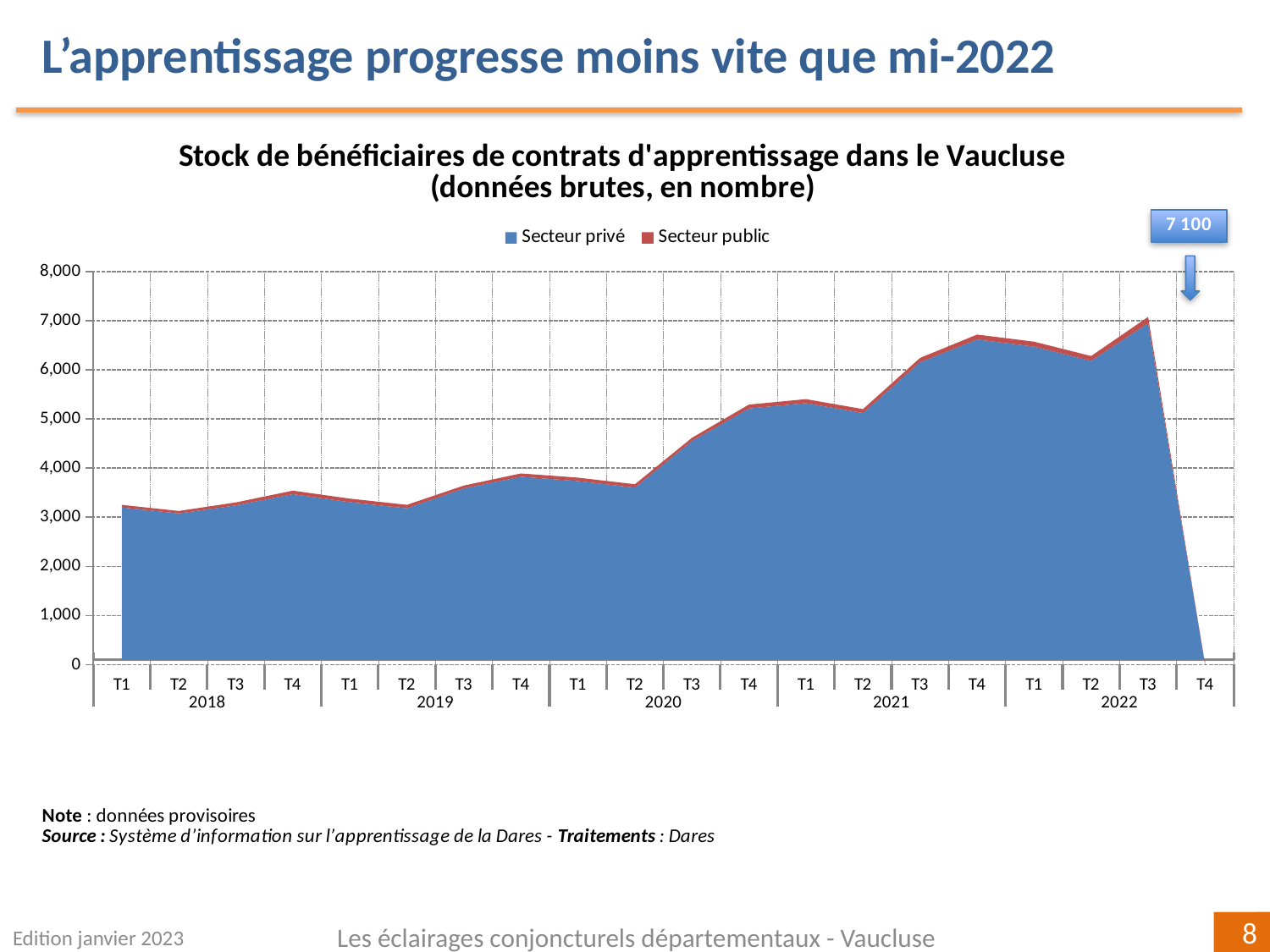
Is the total value for T3 2020 greater or less than 5,000? less How many quarters (T1–T4 points) are shown along the x axis? 20 Is the total value for T2 2020 greater or less than 4,000? less How many series does the legend list? 2 What value does the callout box above T4 2022 show? 7 100 Is the total value for T1 2018 greater or less than 3,000? greater What kind of chart is shown on the slide? Area chart Does the stock of apprenticeship beneficiaries rise or fall between T2 2020 and T3 2022? rise Which two series are listed in the legend? Secteur privé and Secteur public Which quarter has the highest plotted stock of apprenticeship beneficiaries? T3 2022 Which is larger, the total for T4 2021 or the total for T2 2022? T4 2021